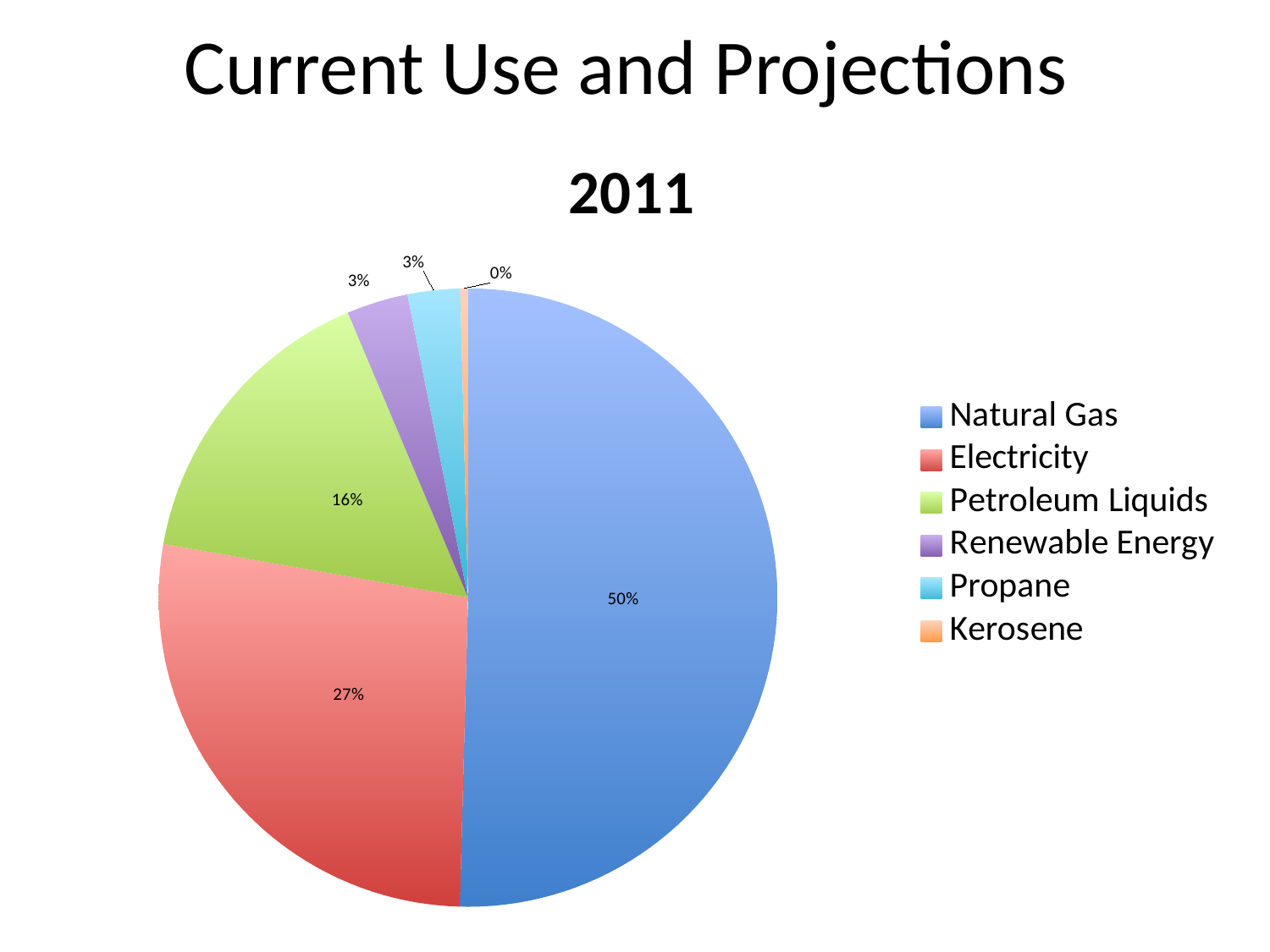
What is the chart's title? 2011 What share of the pie does Electricity have? 27% What type of chart is shown on the slide? pie chart How many categories does the legend list? 6 Which category has the largest slice of the pie? Natural Gas What is the difference between the Natural Gas share and the Electricity share? 23% What share of the pie does Natural Gas have? 50% Which is larger, the Electricity share or the Petroleum Liquids share? Electricity Which category has the smallest slice of the pie? Kerosene What share of the pie does Petroleum Liquids have? 16% What colour is the Propane slice? light blue